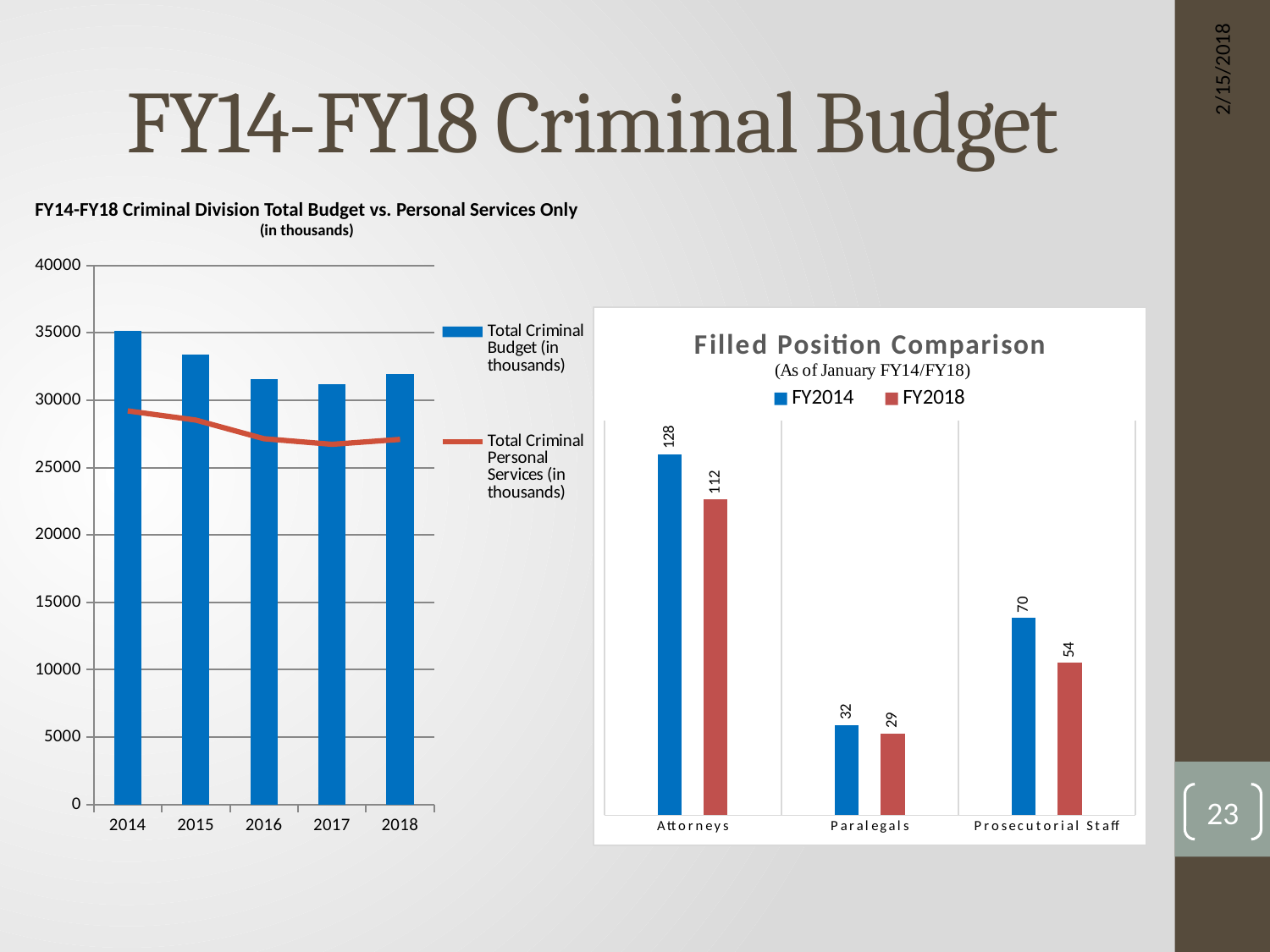
In the FY14-FY18 Criminal Division Total Budget vs. Personal Services Only chart, how many years are shown on the x axis? 5 In the Filled Position Comparison chart, what is the difference between the FY2014 and FY2018 values for Attorneys? 16 In the Filled Position Comparison chart, what is the FY2018 value for Paralegals? 29 In the Filled Position Comparison chart, what is the FY2018 value for Prosecutorial Staff? 54 In the Filled Position Comparison chart, how many categories are shown on the x axis? 3 In the FY14-FY18 Criminal Division Total Budget vs. Personal Services Only chart, which year has the highest Total Criminal Budget bar? 2014 In the Filled Position Comparison chart, what is the difference between the FY2014 and FY2018 values for Prosecutorial Staff? 16 In the FY14-FY18 Criminal Division Total Budget vs. Personal Services Only chart, is the Total Criminal Personal Services value for 2017 greater or less than 30000? less In the Filled Position Comparison chart, which category has the lowest FY2014 value? Paralegals In the Filled Position Comparison chart, what is the FY2014 value for Attorneys? 128 In the FY14-FY18 Criminal Division Total Budget vs. Personal Services Only chart, is the Total Criminal Budget for 2016 greater or less than 30000? greater In the Filled Position Comparison chart, how many series does the legend list? 2